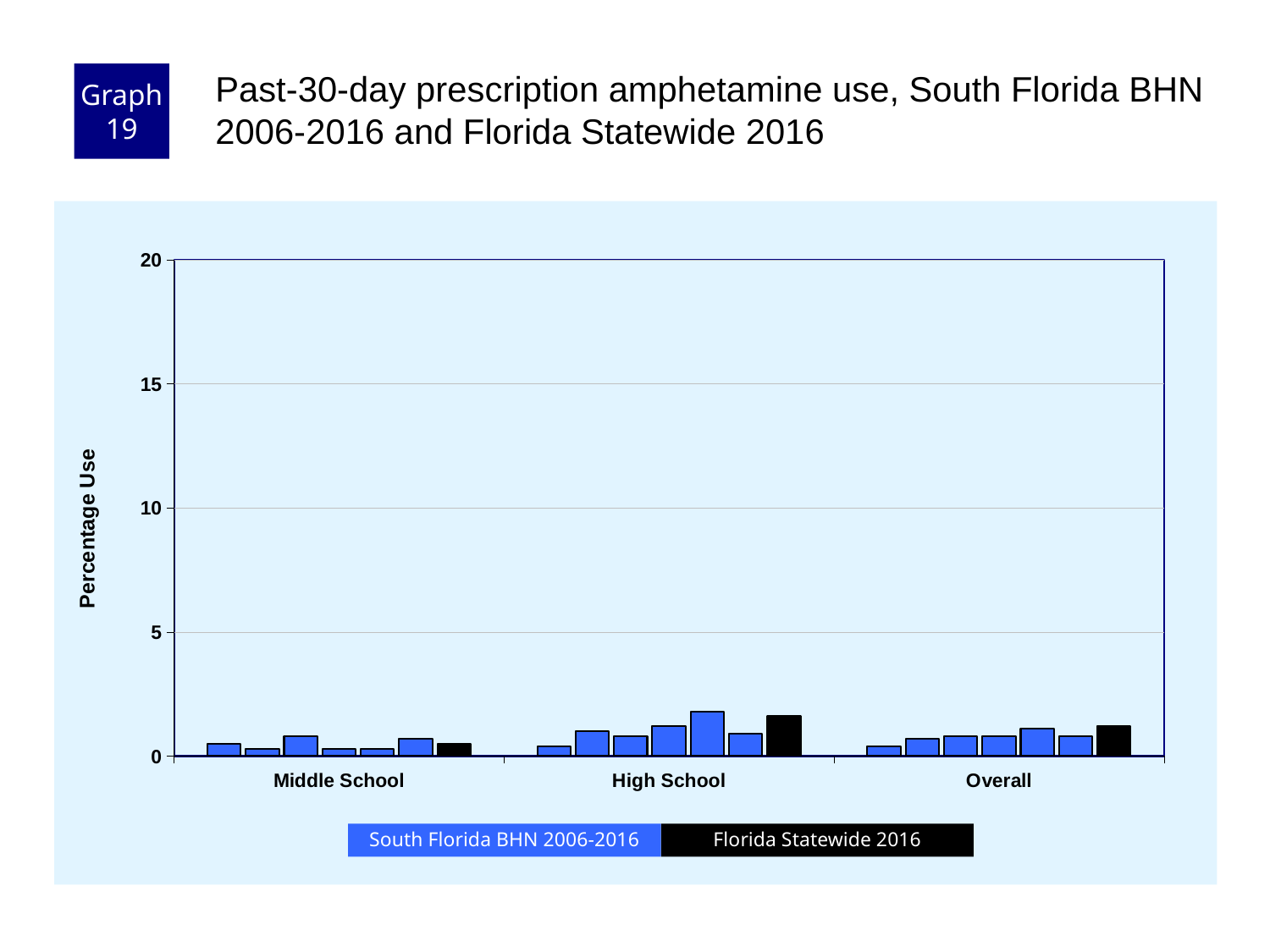
How many series does the legend list? 2 How many bars are plotted in the High School group? 7 Which series is shown in black in the legend? Florida Statewide 2016 What is the label of the y axis? Percentage Use Which category has the highest Florida Statewide 2016 value? High School Which is larger, the Florida Statewide 2016 value for High School or for Middle School? High School How many categories are shown on the x axis? 3 Which category has the lowest Florida Statewide 2016 value? Middle School Is the Florida Statewide 2016 value for High School greater or less than 5? less What kind of chart is shown on the slide? bar chart Which is larger, the Florida Statewide 2016 value for Overall or for Middle School? Overall Is the Florida Statewide 2016 value for Overall greater or less than 10? less